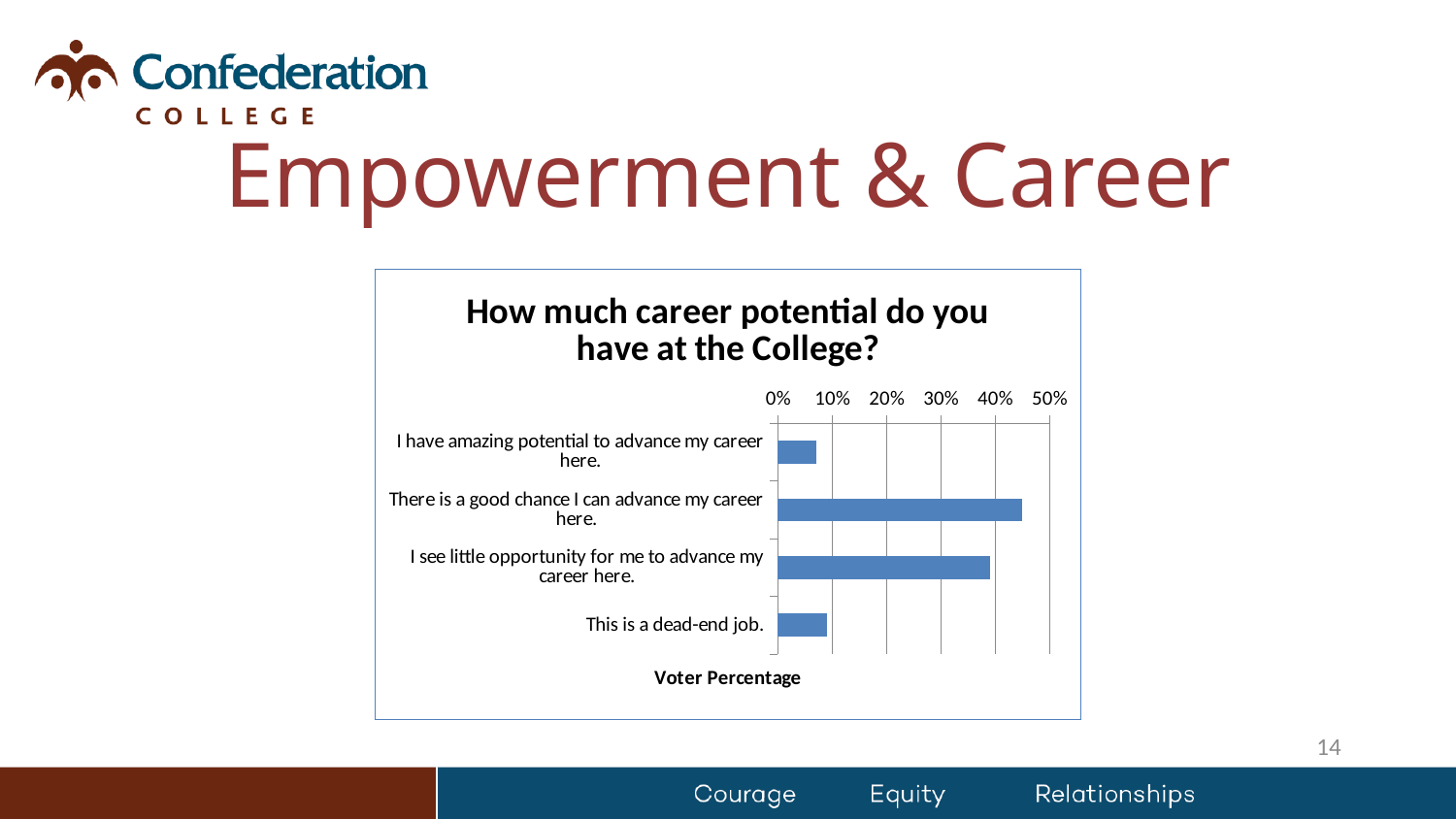
Which is larger: the value for "There is a good chance I can advance my career here." or the value for "I see little opportunity for me to advance my career here."? There is a good chance I can advance my career here. What is the title of the chart? How much career potential do you have at the College? Is the value for "I see little opportunity for me to advance my career here." greater or less than 30%? greater What is the label on the value axis of the chart? Voter Percentage What kind of chart is shown on the slide? bar chart Which is larger: the value for "This is a dead-end job." or the value for "There is a good chance I can advance my career here."? There is a good chance I can advance my career here. Is the value for "I have amazing potential to advance my career here." greater or less than 10%? less Is the value for "There is a good chance I can advance my career here." greater or less than 40%? greater How many categories (response options) are plotted in the chart? 4 Which response has the highest voter percentage? There is a good chance I can advance my career here.